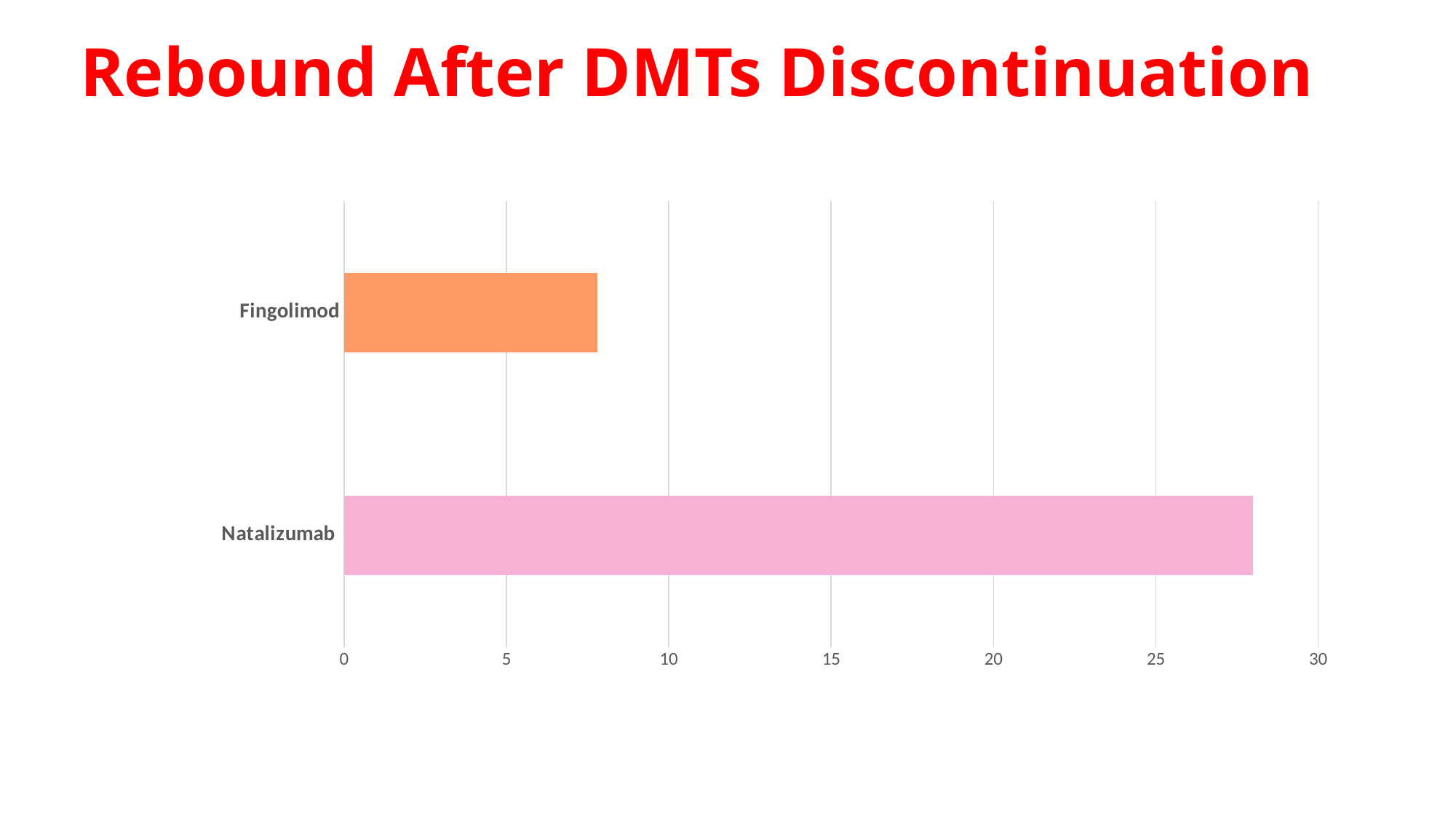
Which category has the highest value? Natalizumab What is the maximum value shown on the horizontal axis? 30 Is the value for Natalizumab greater or less than 30? less Which is larger, the value for Natalizumab or the value for Fingolimod? Natalizumab What kind of chart is shown on the slide? bar chart Is the value for Fingolimod greater or less than 10? less Is the value for Natalizumab greater or less than 25? greater Which category has the lowest value? Fingolimod How many categories are plotted in the chart? 2 What is the title of the slide? Rebound After DMTs Discontinuation What colour is the bar for Natalizumab? pink